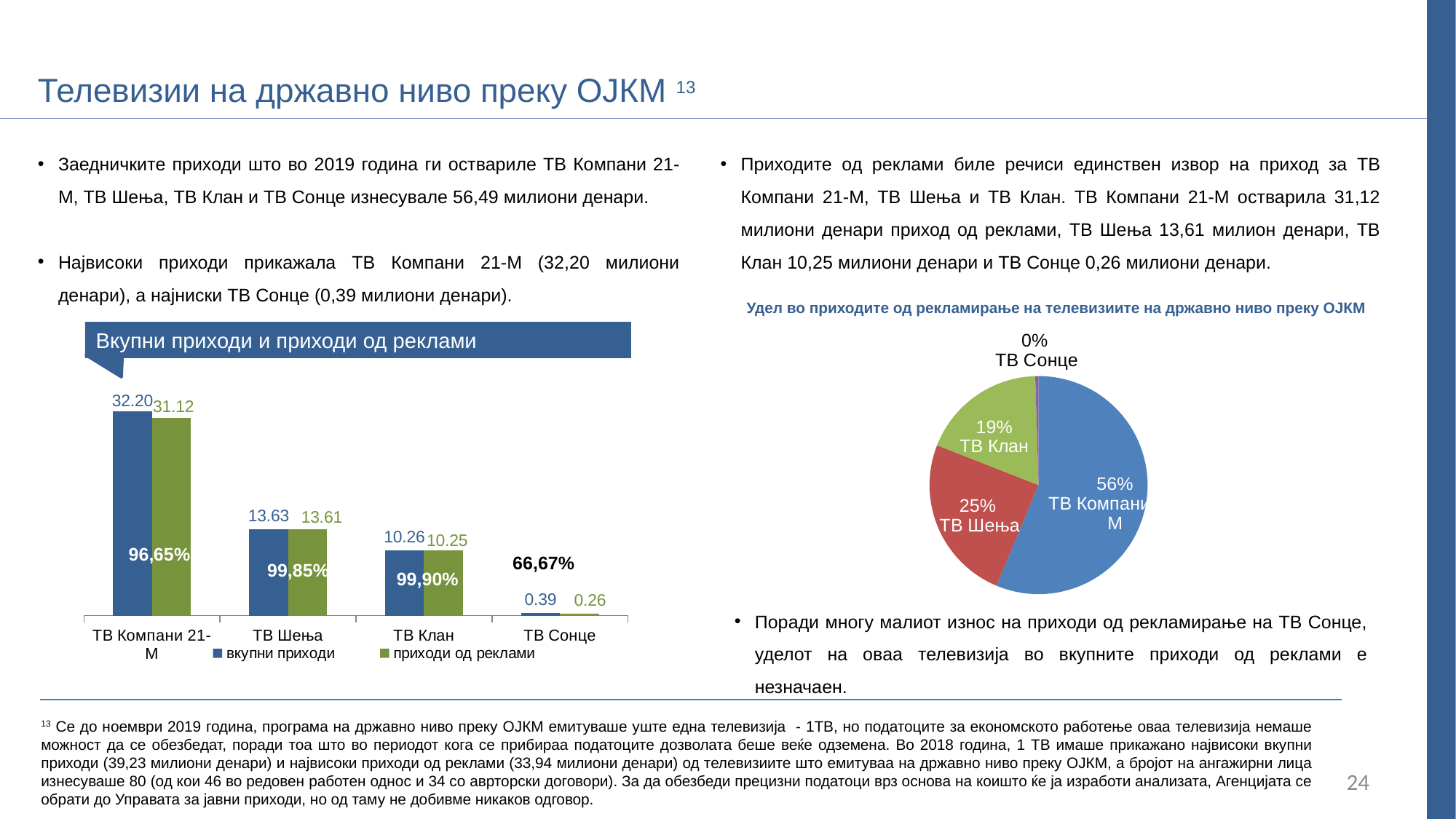
In the pie chart 'Удел во приходите од рекламирање на телевизиите на државно ниво преку ОЈКМ', which is larger, the share of ТВ Шења or ТВ Клан? ТВ Шења In the bar chart 'Вкупни приходи и приходи од реклами', what is the value of 'приходи од реклами' for ТВ Сонце? 0.26 In the bar chart 'Вкупни приходи и приходи од реклами', how many series does the legend list? 2 In the pie chart 'Удел во приходите од рекламирање на телевизиите на државно ниво преку ОЈКМ', what share does ТВ Компани 21-М have? 56% In the bar chart 'Вкупни приходи и приходи од реклами', how many categories are shown on the x axis? 4 In the bar chart 'Вкупни приходи и приходи од реклами', which category has the lowest 'приходи од реклами'? ТВ Сонце In the pie chart 'Удел во приходите од рекламирање на телевизиите на државно ниво преку ОЈКМ', which television has the largest share? ТВ Компани 21-М What kind of chart is 'Вкупни приходи и приходи од реклами'? bar chart In the bar chart 'Вкупни приходи и приходи од реклами', what is the value of 'вкупни приходи' for ТВ Компани 21-М? 32.20 In the bar chart 'Вкупни приходи и приходи од реклами', which category has the highest 'вкупни приходи'? ТВ Компани 21-М In the bar chart 'Вкупни приходи и приходи од реклами', what is the difference between 'вкупни приходи' and 'приходи од реклами' for ТВ Компани 21-М? 1.08 In the bar chart 'Вкупни приходи и приходи од реклами', what is the value of 'приходи од реклами' for ТВ Шења? 13.61